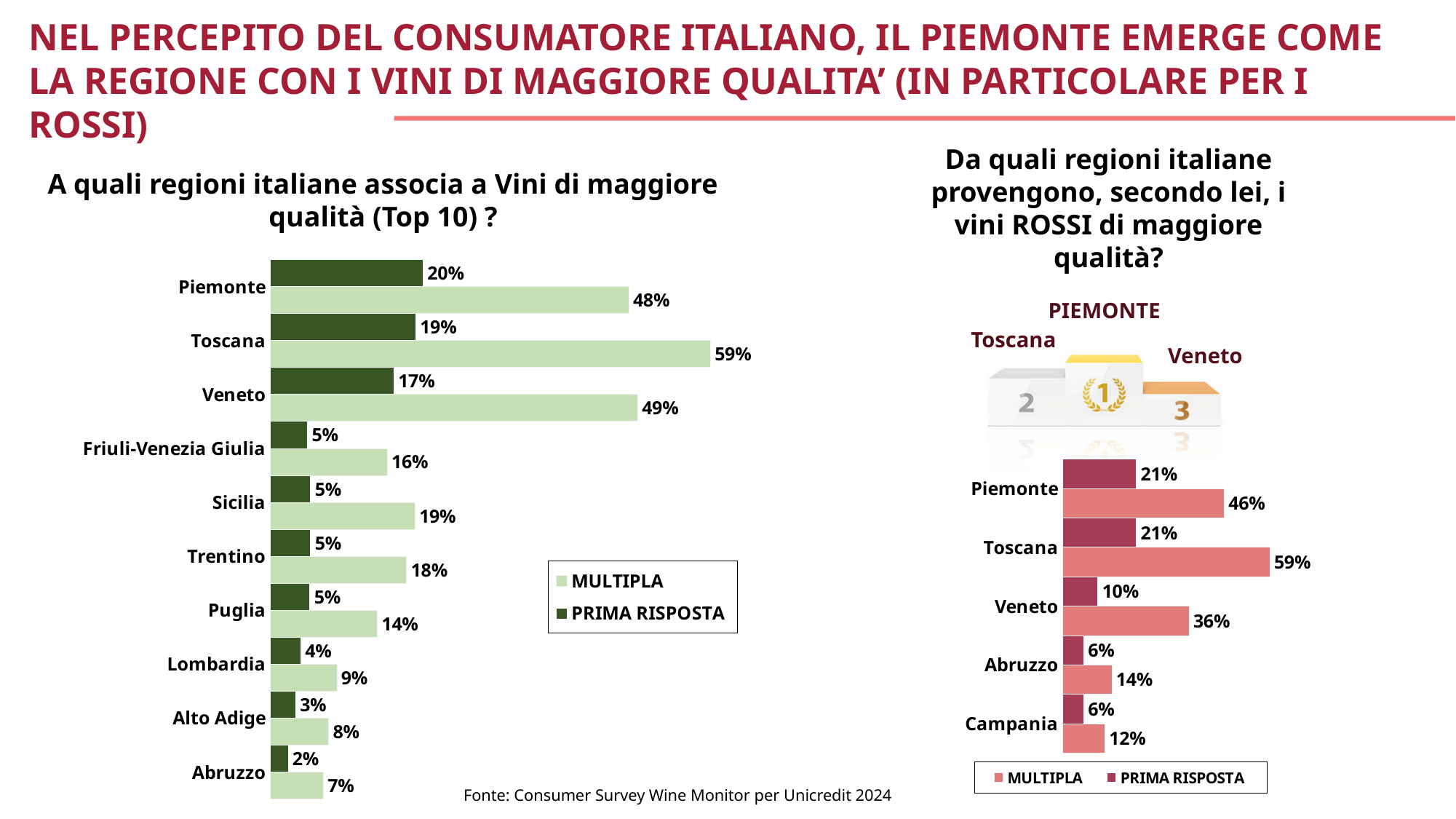
In the right chart (regions for higher-quality RED wines), is the MULTIPLA value for Piemonte or Veneto larger? Piemonte In the right chart (regions for higher-quality RED wines), what is the MULTIPLA value for Veneto? 36% In the right chart (regions for higher-quality RED wines), what is the difference between the MULTIPLA and PRIMA RISPOSTA values for Toscana? 38% In the left chart (Top 10 regions for higher-quality wines), which region has the highest MULTIPLA value? Toscana In the left chart (Top 10 regions for higher-quality wines), which region has the lowest PRIMA RISPOSTA value? Abruzzo In the left chart (Top 10 regions for higher-quality wines), how many regions are shown? 10 In the right chart (regions for higher-quality RED wines), how many series does the legend list? 2 In the left chart (Top 10 regions for higher-quality wines), what is the PRIMA RISPOSTA value for Veneto? 17% In the left chart (Top 10 regions for higher-quality wines), what is the MULTIPLA value for Piemonte? 48% In the right chart (regions for higher-quality RED wines), which region has the highest MULTIPLA value? Toscana In the left chart (Top 10 regions for higher-quality wines), what type of chart is used? Bar chart In the left chart (Top 10 regions for higher-quality wines), what is the difference between the MULTIPLA values for Toscana and Piemonte? 11%